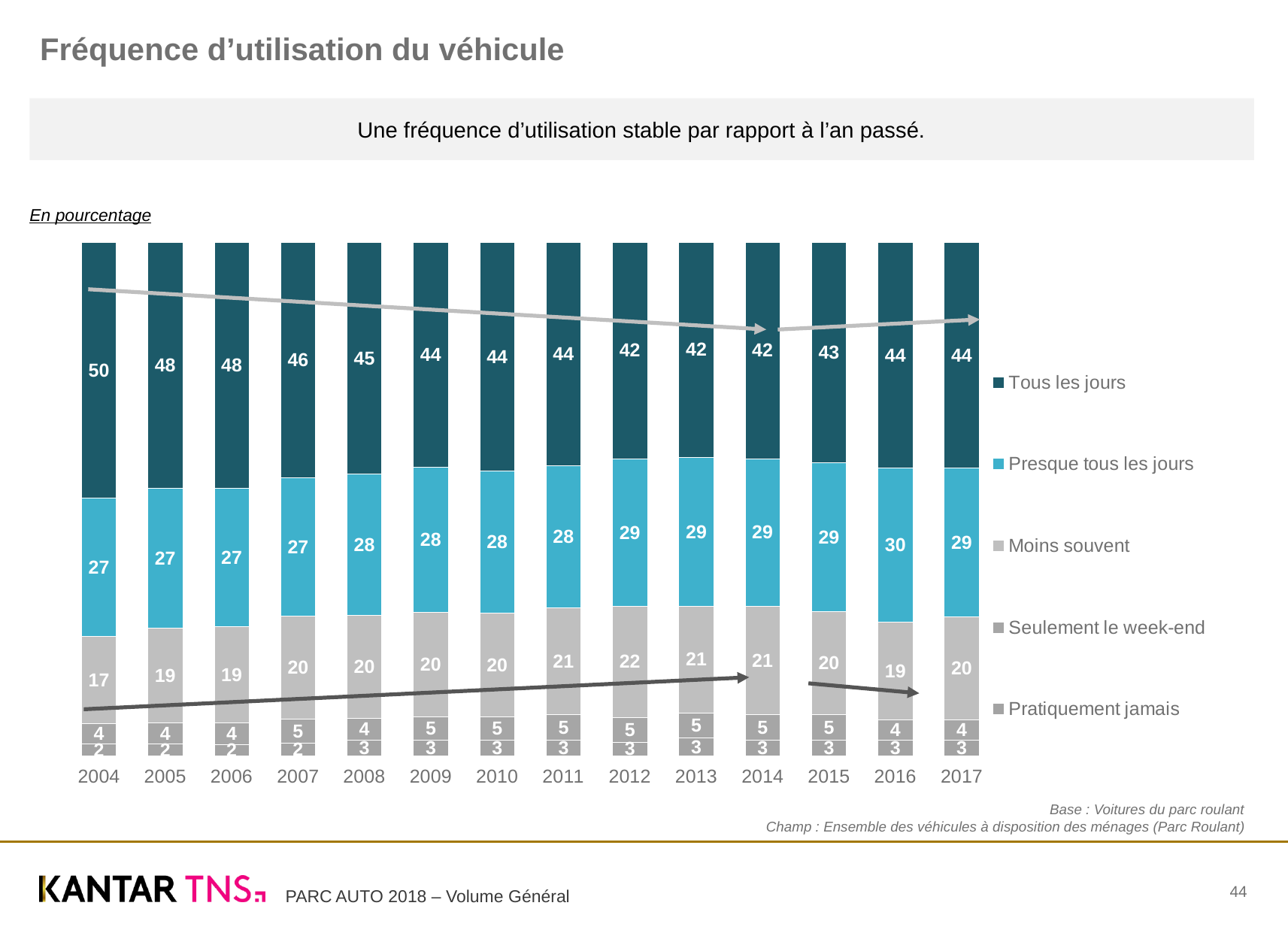
Does the "Tous les jours" value rise or fall from 2004 to 2014? Fall How many series does the legend list? 5 How many years are shown on the x axis? 14 What is the title of the slide containing the chart? Fréquence d’utilisation du véhicule What is the value for "Tous les jours" in 2004? 50 What is the value for "Moins souvent" in 2012? 22 In which year is the "Moins souvent" value lowest? 2004 Which is larger: the "Presque tous les jours" value in 2004 or in 2017? 2017 What is the value for "Presque tous les jours" in 2016? 30 What is the difference between the "Tous les jours" value in 2004 and in 2017? 6 In which year is the "Tous les jours" value highest? 2004 What type of chart is shown on the slide? Stacked bar chart